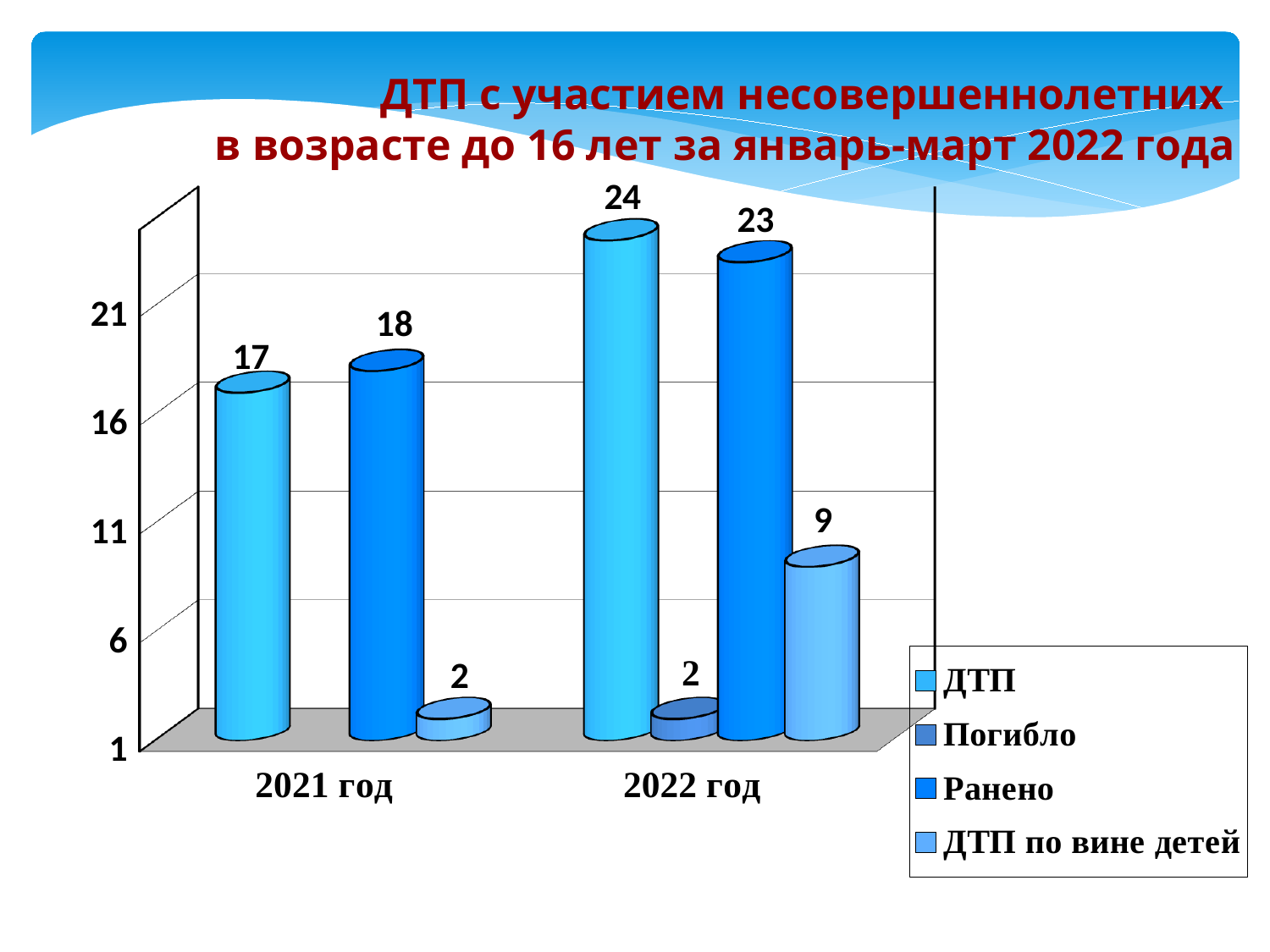
What is the difference between the Ранено values for 2022 год and 2021 год? 5 Which bar has the highest value on the chart? ДТП in 2022 год (24) What is the value for Погибло in 2022 год? 2 What is the value for ДТП по вине детей in 2022 год? 9 What is the value for Ранено in 2021 год? 18 What is the value for ДТП in 2022 год? 24 How many series does the legend list? 4 By how much did the ДТП value increase from 2021 год to 2022 год? 7 Does the ДТП value rise or fall from 2021 год to 2022 год? Rise Which is larger in 2021 год: ДТП or Ранено? Ранено How many year categories are shown on the x axis? 2 What kind of chart is shown on the slide? Bar chart